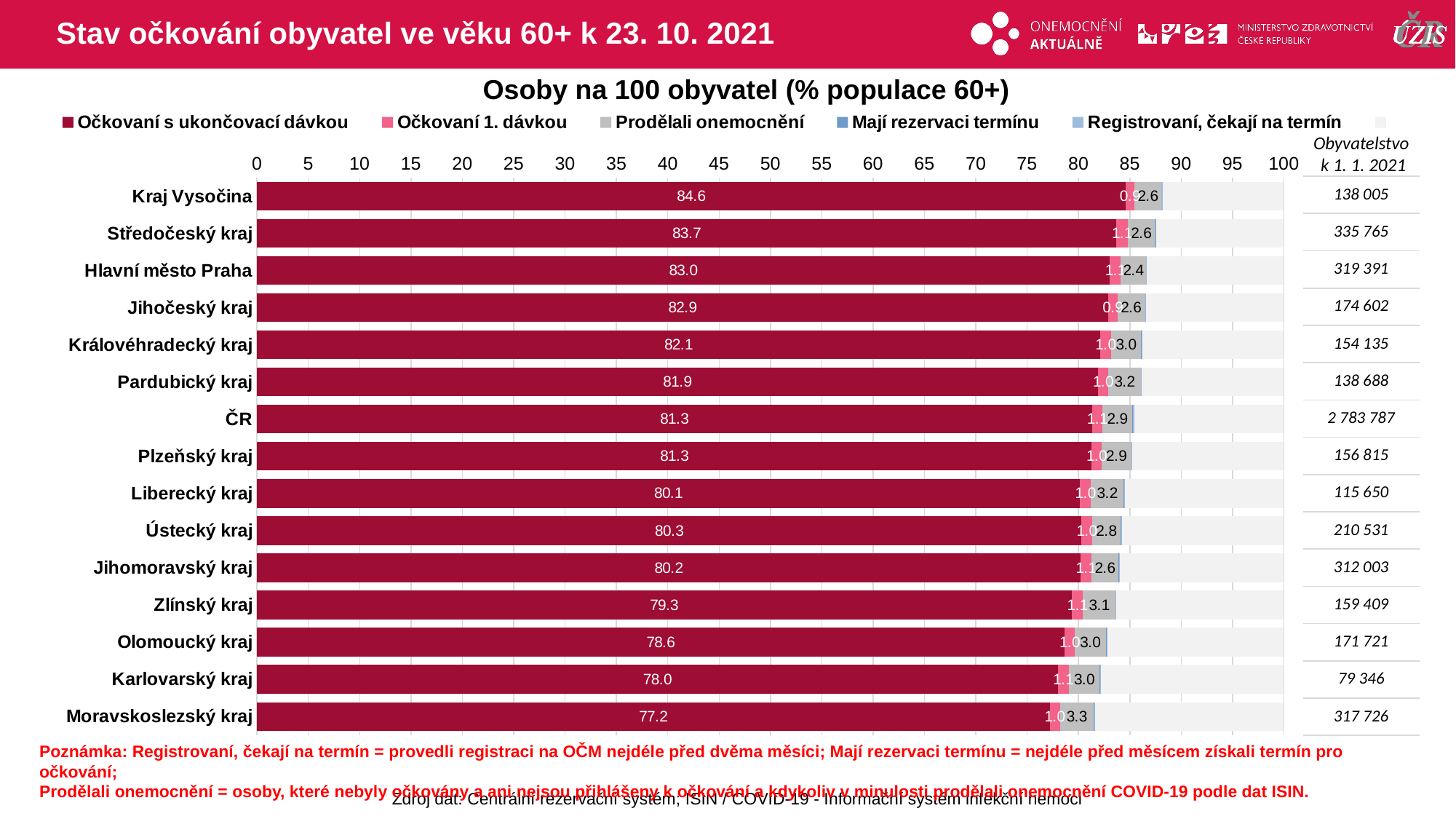
What is the value of "Prodělali onemocnění" for Moravskoslezský kraj? 3.3 What is the difference in "Očkovaní s ukončovací dávkou" between Středočeský kraj and Hlavní město Praha? 0.7 Is the value of "Očkovaní s ukončovací dávkou" for Karlovarský kraj greater or less than 80? less Which has a higher value of "Očkovaní s ukončovací dávkou": Ústecký kraj or Liberecký kraj? Ústecký kraj Which region has the lowest value of "Očkovaní s ukončovací dávkou"? Moravskoslezský kraj What type of chart is shown on the slide? bar chart What is the value of "Očkovaní s ukončovací dávkou" for Moravskoslezský kraj? 77.2 What is the value of "Očkovaní s ukončovací dávkou" for Kraj Vysočina? 84.6 Which region has the highest value of "Očkovaní s ukončovací dávkou"? Kraj Vysočina What is the value of "Očkovaní s ukončovací dávkou" for ČR? 81.3 What is the difference in "Očkovaní s ukončovací dávkou" between Kraj Vysočina and Moravskoslezský kraj? 7.4 How many categories (rows) are shown in the chart? 15